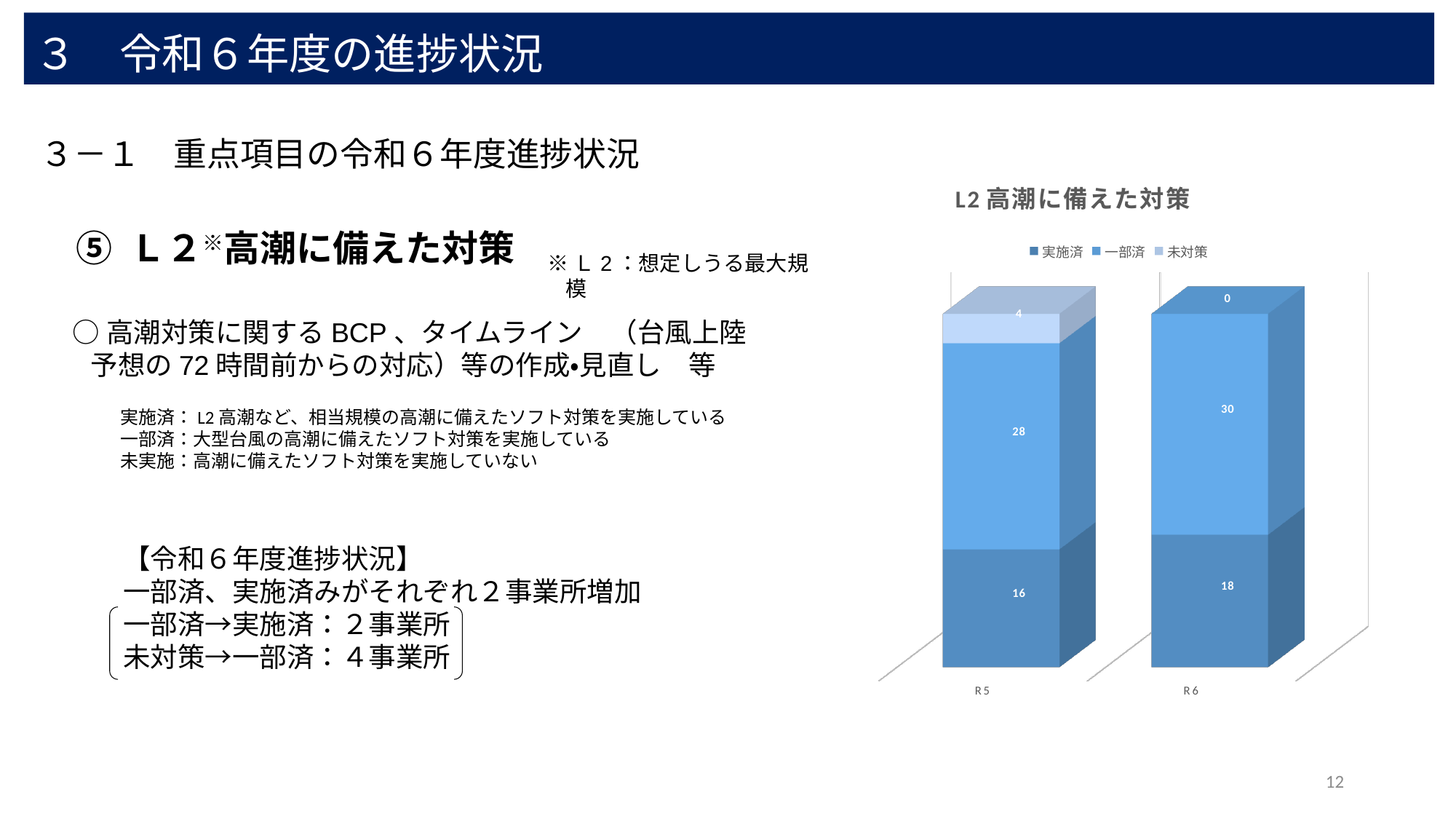
What is the total of the stacked bar for R5? 48 How many series does the legend list? 3 What is the total of the stacked bar for R6? 48 What is the value of 未対策 for R6? 0 What is the value of 実施済 for R5? 16 What is the difference between the 一部済 values for R6 and R5? 2 What is the value of 一部済 for R6? 30 What is the value of 未対策 for R5? 4 What is the title of the chart? L2 高潮に備えた対策 What kind of chart is shown? Stacked bar chart How many categories are shown on the x axis? 2 Which is larger, 実施済 for R5 or 実施済 for R6? R6